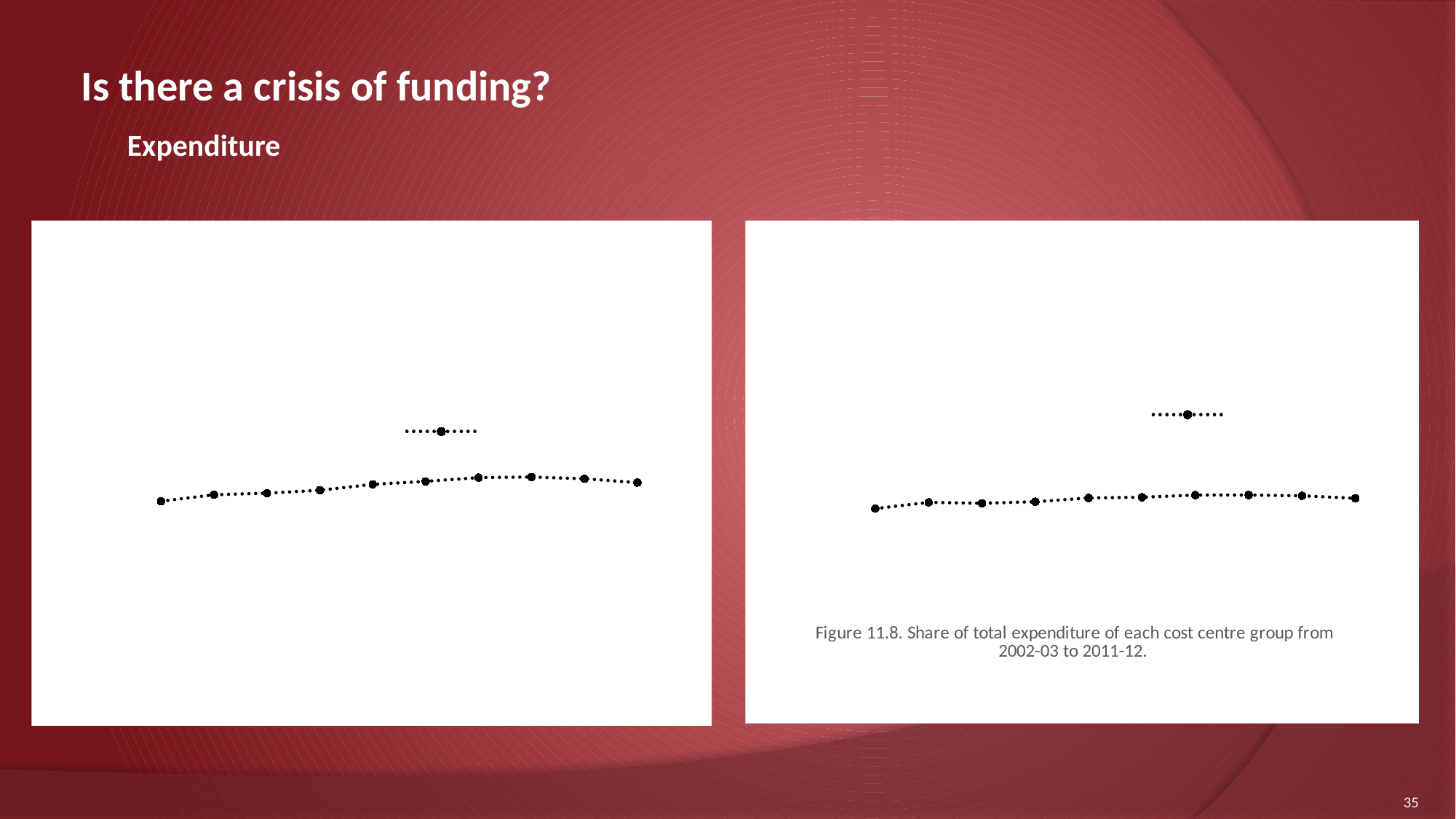
What figure number is given in the caption of the chart on the right of the slide? Figure 11.8 How many data points are plotted on the line in the chart on the left of the slide? 10 What period does the caption of the chart on the right of the slide (Figure 11.8) say the data covers? 2002-03 to 2011-12 What kind of chart is the chart on the right of the slide (Figure 11.8)? line chart What kind of chart is the chart on the left of the slide? line chart In the chart on the left of the slide, is the last point higher or lower than the first point? higher In the chart on the right of the slide (Figure 11.8), do the values rise or fall from the first point to the last point along the x axis? rise How many data points are plotted on the line in the chart on the right of the slide (Figure 11.8)? 10